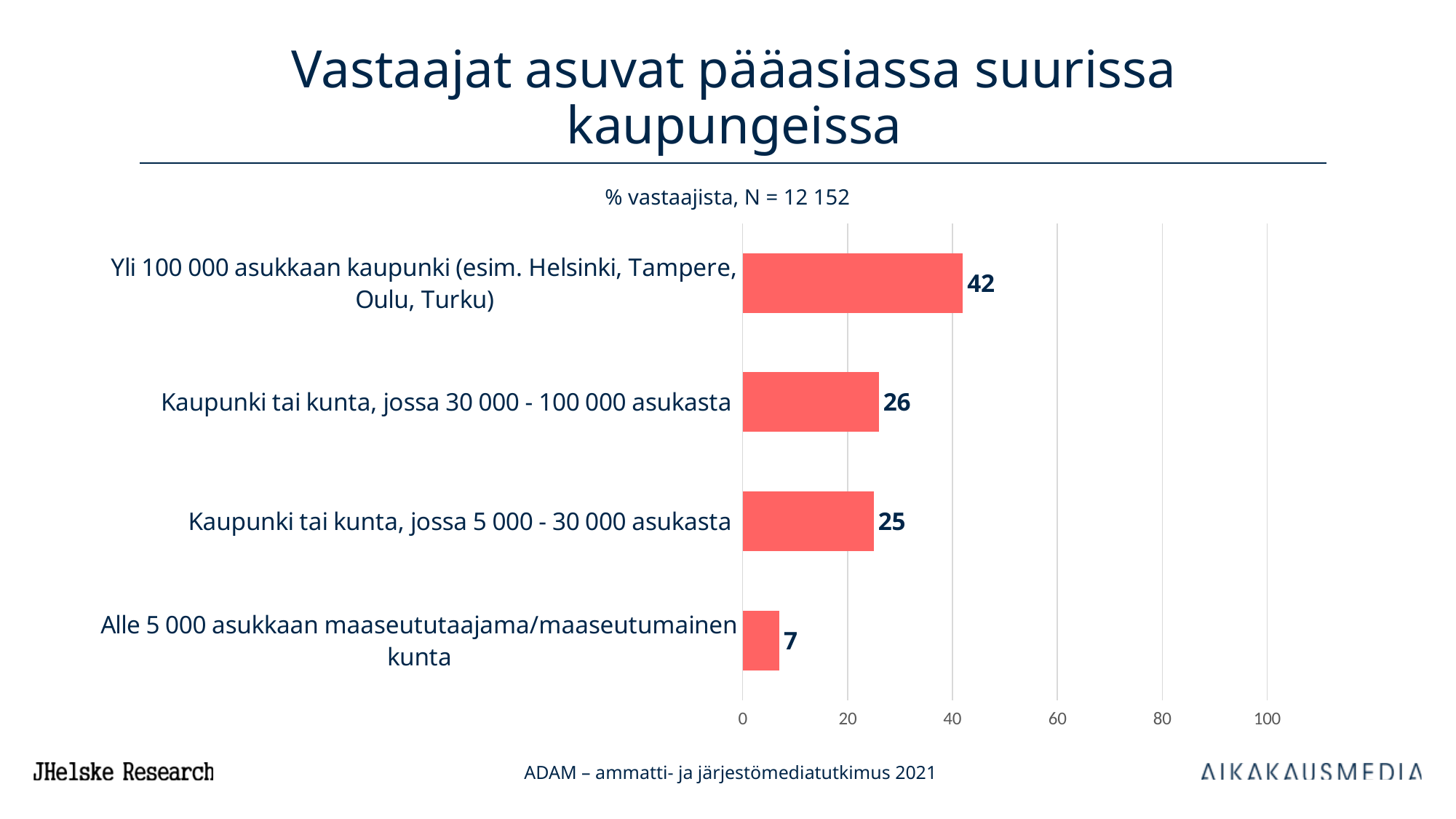
Which is larger: the value for "Kaupunki tai kunta, jossa 30 000 - 100 000 asukasta" or the value for "Alle 5 000 asukkaan maaseututaajama/maaseutumainen kunta"? Kaupunki tai kunta, jossa 30 000 - 100 000 asukasta Which category has the highest value? Yli 100 000 asukkaan kaupunki (esim. Helsinki, Tampere, Oulu, Turku) What kind of chart is shown on the slide? bar chart Is the value for "Yli 100 000 asukkaan kaupunki" greater or less than 40? greater What is the value for "Alle 5 000 asukkaan maaseututaajama/maaseutumainen kunta"? 7 What is the difference between the value for "Kaupunki tai kunta, jossa 5 000 - 30 000 asukasta" and the value for "Alle 5 000 asukkaan maaseututaajama/maaseutumainen kunta"? 18 Which category has the lowest value? Alle 5 000 asukkaan maaseututaajama/maaseutumainen kunta What is the sample size (N) stated above the chart? 12 152 How many categories are shown in the chart? 4 What is the difference between the value for "Yli 100 000 asukkaan kaupunki" and the value for "Kaupunki tai kunta, jossa 30 000 - 100 000 asukasta"? 16 What is the value for "Yli 100 000 asukkaan kaupunki (esim. Helsinki, Tampere, Oulu, Turku)"? 42 What is the value for "Kaupunki tai kunta, jossa 30 000 - 100 000 asukasta"? 26